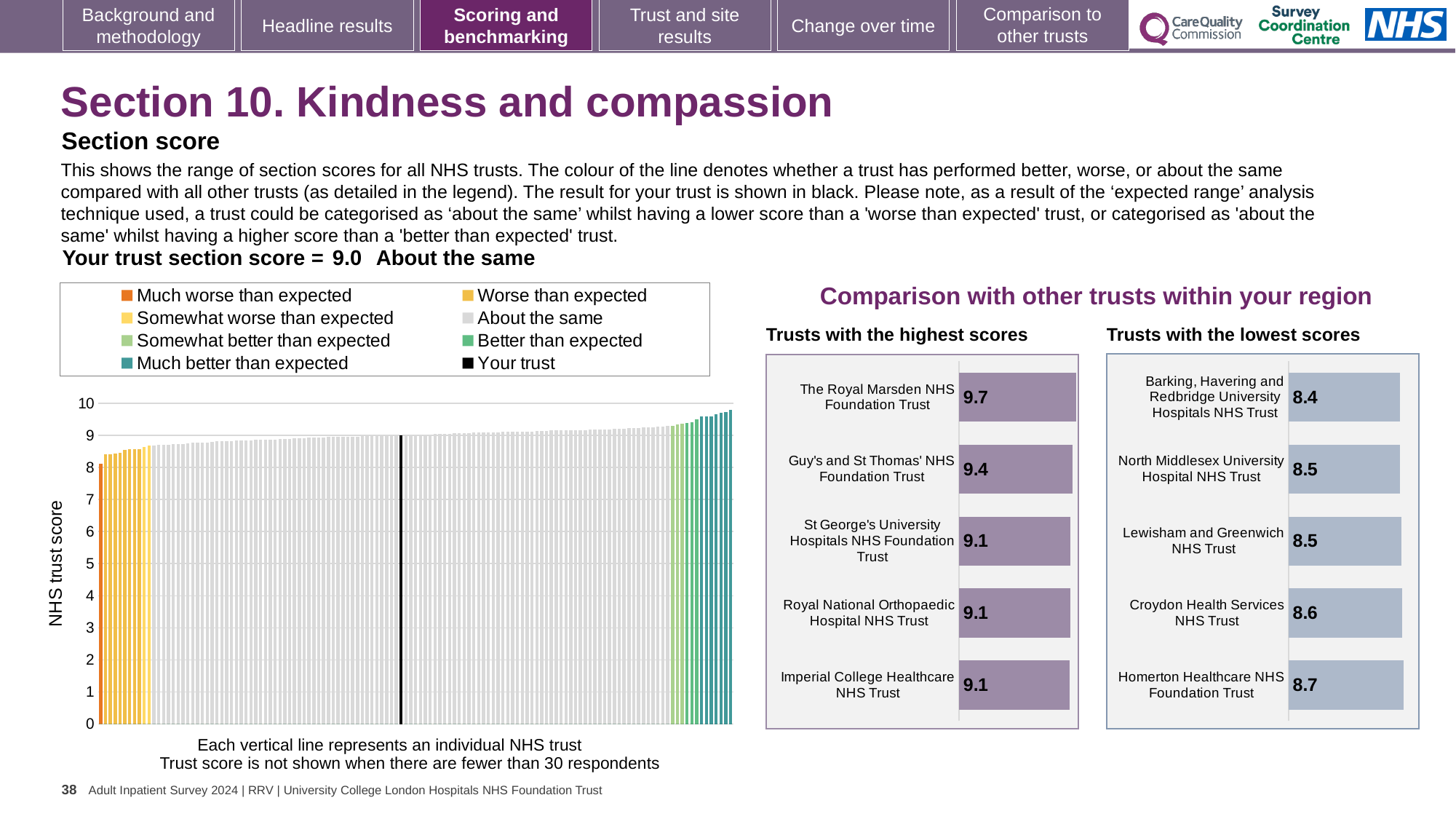
In the 'Trusts with the lowest scores' chart, what is the score for Croydon Health Services NHS Trust? 8.6 In the 'Trusts with the highest scores' chart, what is the score for The Royal Marsden NHS Foundation Trust? 9.7 In the 'Trusts with the lowest scores' chart, which trust has the lowest score? Barking, Havering and Redbridge University Hospitals NHS Trust In the 'Trusts with the highest scores' chart, which trust has the highest score? The Royal Marsden NHS Foundation Trust How many entries does the legend of the NHS trust score chart on the left list? 8 In the 'Trusts with the lowest scores' chart, which has the higher score: Croydon Health Services NHS Trust or North Middlesex University Hospital NHS Trust? Croydon Health Services NHS Trust How many trusts are shown in the 'Trusts with the highest scores' chart? 5 In the NHS trust score chart on the left, what is the label of the y axis? NHS trust score In the NHS trust score chart on the left, do the values rise or fall from left to right along the x axis? Rise In the 'Trusts with the lowest scores' chart, what is the difference between the scores of Homerton Healthcare NHS Foundation Trust and Barking, Havering and Redbridge University Hospitals NHS Trust? 0.3 In the 'Trusts with the highest scores' chart, what is the difference between the scores of The Royal Marsden NHS Foundation Trust and Guy's and St Thomas' NHS Foundation Trust? 0.3 What kind of chart is the 'Trusts with the lowest scores' chart? Bar chart